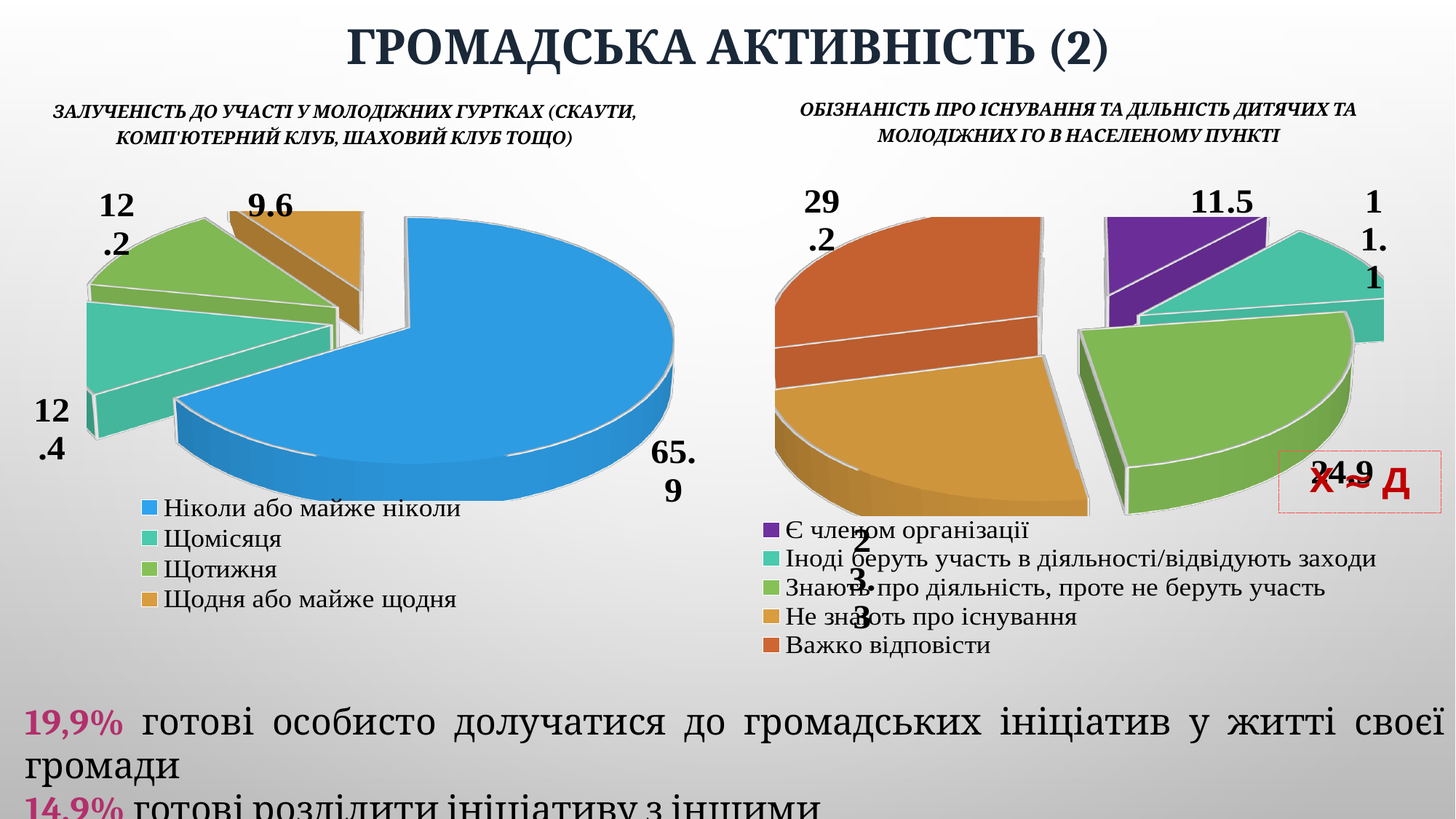
In the left chart (participation in youth clubs), what is the value for 'Ніколи або майже ніколи'? 65.9 In the right chart (awareness of children's and youth NGOs), which category has the largest share? Важко відповісти In the left chart (participation in youth clubs), which category has the smallest share? Щодня або майже щодня What kind of chart is the left chart on the slide? Pie chart In the right chart (awareness of children's and youth NGOs), what is the value for 'Важко відповісти'? 29.2 In the left chart (participation in youth clubs), which category has the largest share? Ніколи або майже ніколи In the left chart (participation in youth clubs), what is the difference between the values for 'Ніколи або майже ніколи' and 'Щодня або майже щодня'? 56.3 How many categories does the legend of the right chart list? 5 How many categories does the legend of the left chart list? 4 In the left chart (participation in youth clubs), what is the value for 'Щодня або майже щодня'? 9.6 In the right chart (awareness of children's and youth NGOs), which is larger: 'Важко відповісти' or 'Є членом організації'? Важко відповісти In the right chart (awareness of children's and youth NGOs), what is the value for 'Є членом організації'? 11.5